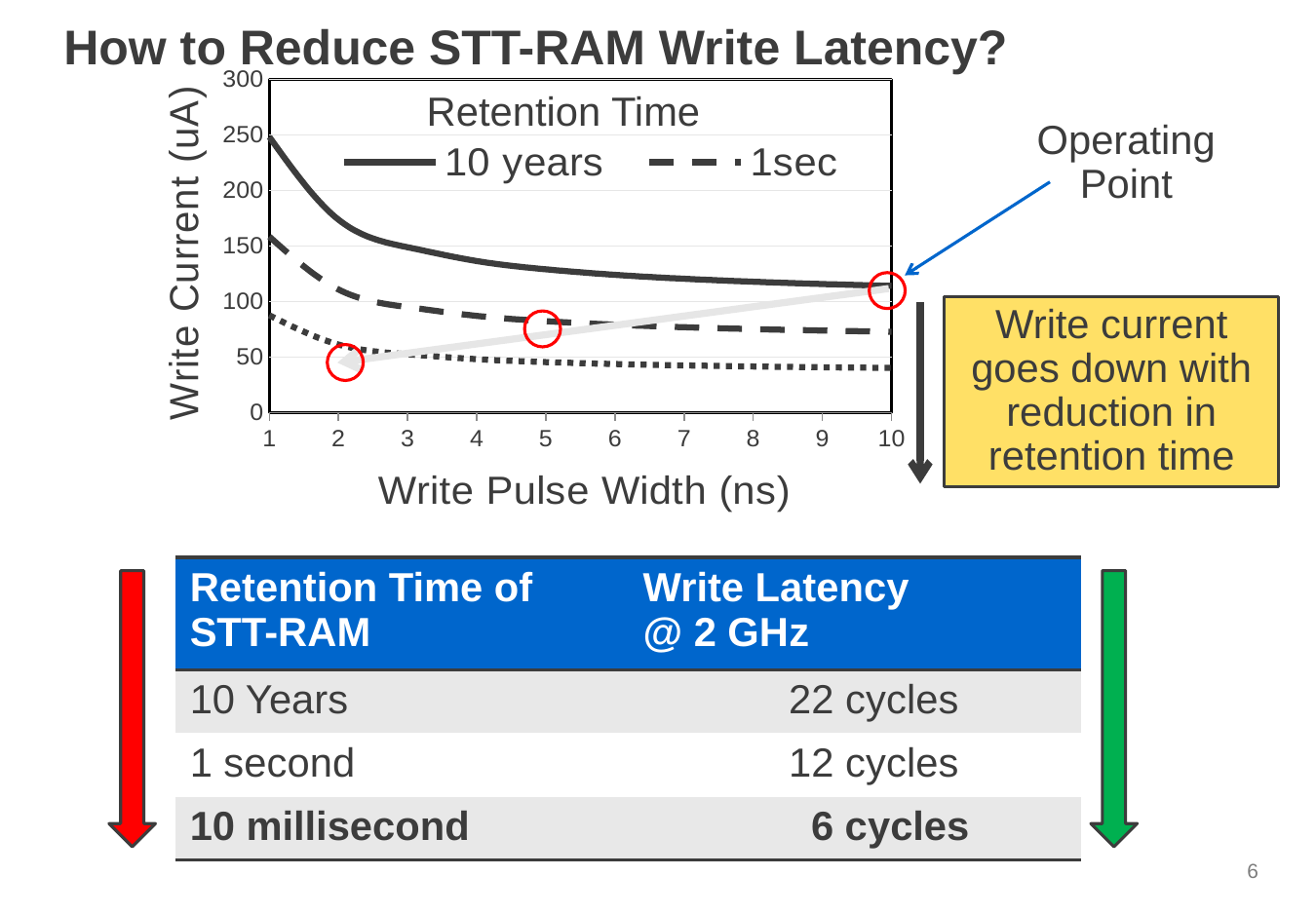
What is the highest value shown on the y axis of the chart? 300 How many tick values are labelled on the x axis of the chart? 10 Does the write current for the 10 years retention time rise or fall as the write pulse width increases? fall At a write pulse width of 5 ns, which retention time has the higher write current, 10 years or 1sec? 10 years What kind of chart is shown on the slide? line chart What is the label of the y axis of the chart? Write Current (uA) Is the write current for the 10 years line at a write pulse width of 1 ns greater or less than 200? greater Is the write current for the 1sec line at a write pulse width of 10 ns greater or less than 100? less Is the write current for the 10 years line at a write pulse width of 10 ns greater or less than 100? greater Does the write current for the 1sec retention time rise or fall as the write pulse width increases? fall What is the label of the x axis of the chart? Write Pulse Width (ns)